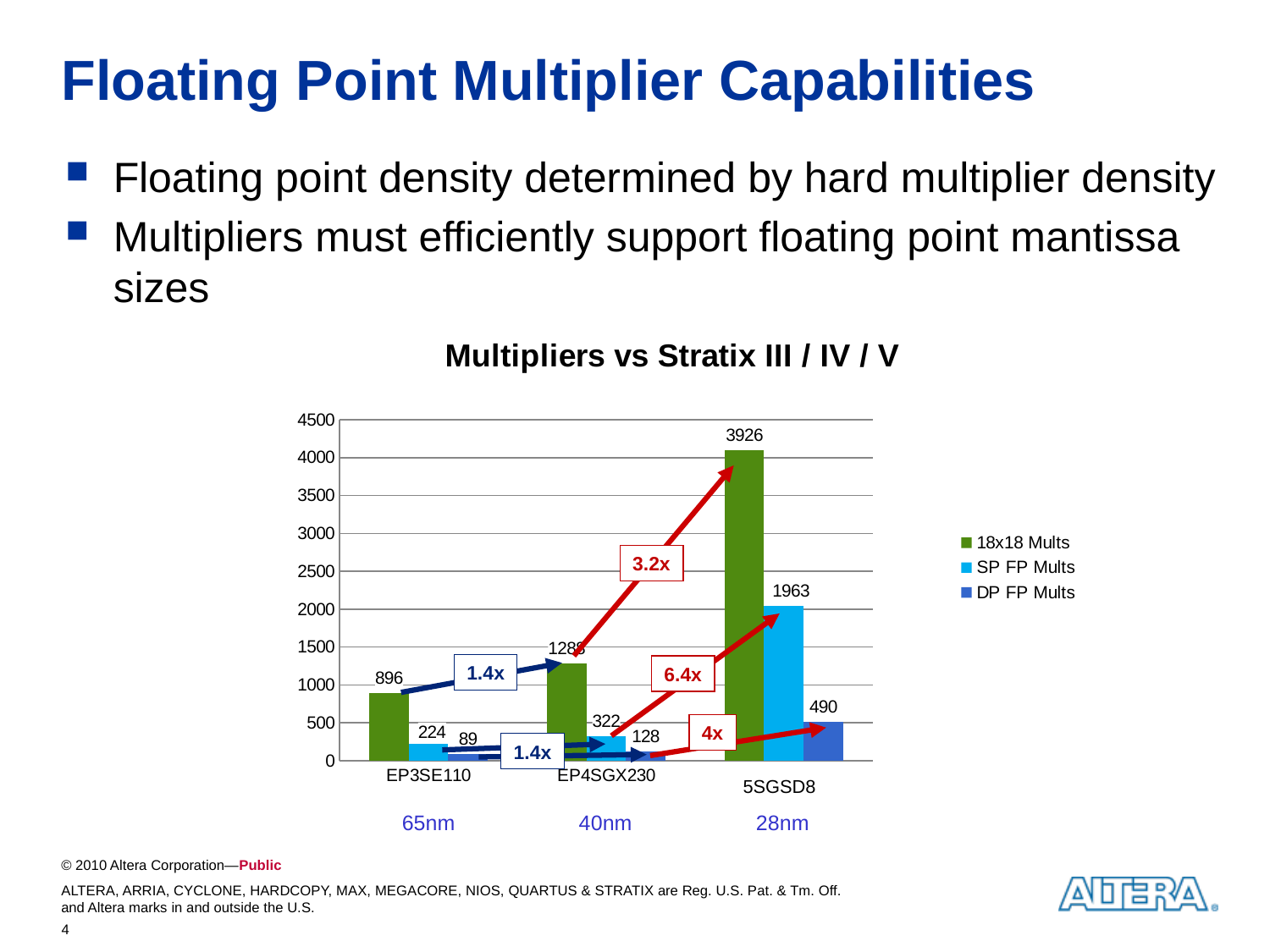
What is the value of 18x18 Mults for 5SGSD8? 3926 Which device has the highest number of 18x18 Mults? 5SGSD8 What type of chart is shown on the slide? bar chart What is the value of DP FP Mults for 5SGSD8? 490 Is the value of 18x18 Mults for EP4SGX230 greater or less than 1000? greater What is the title of the chart? Multipliers vs Stratix III / IV / V What is the difference between SP FP Mults for 5SGSD8 and SP FP Mults for EP4SGX230? 1641 How many device categories are shown on the x axis of the chart? 3 What is the value of DP FP Mults for EP4SGX230? 128 How many series does the chart legend list? 3 Which device has the lowest number of DP FP Mults? EP3SE110 What is the value of SP FP Mults for EP3SE110? 224